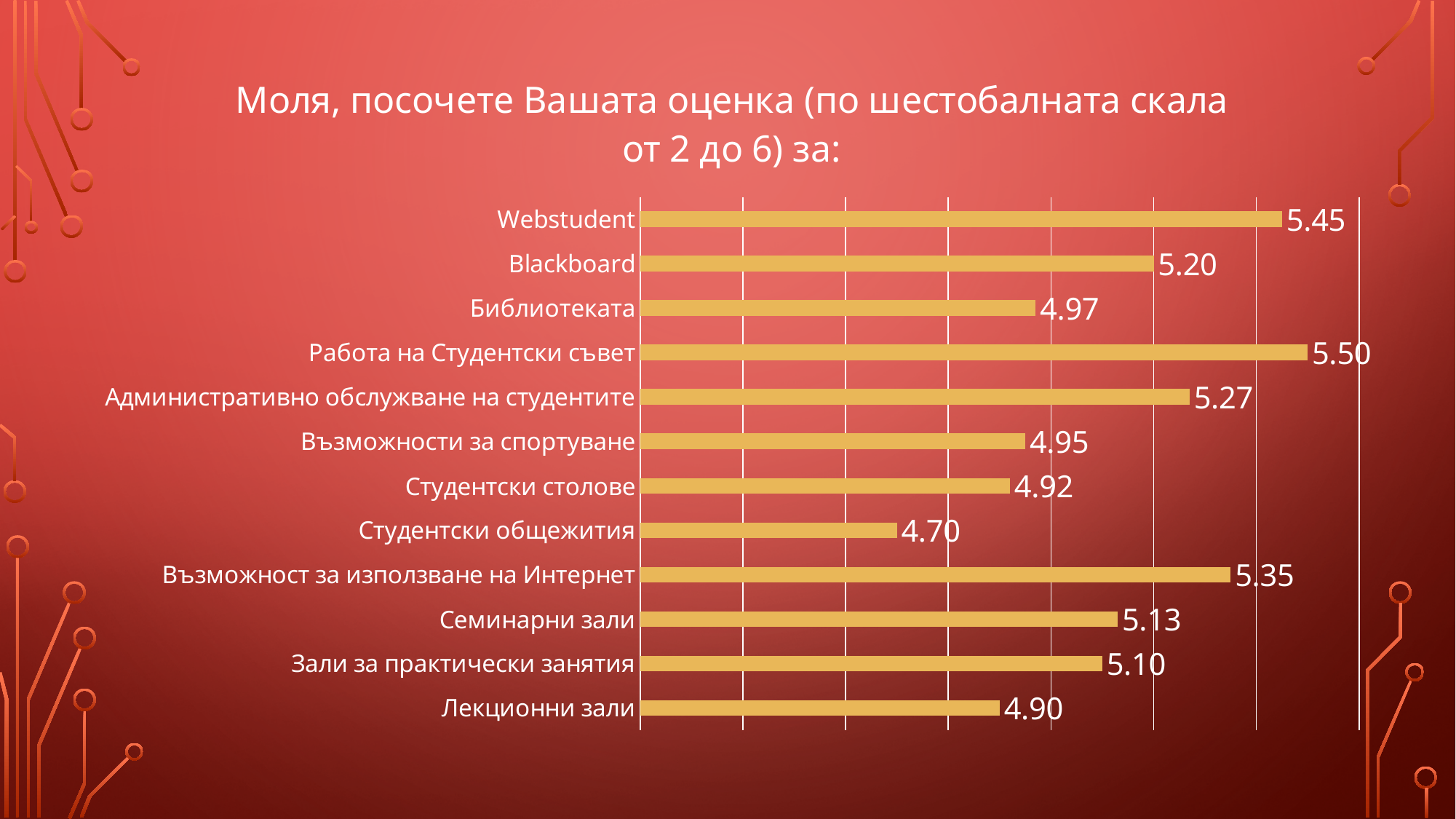
Which category has the highest value? Работа на Студентски съвет What is the difference between the values for Webstudent and Blackboard? 0.25 Which is larger, the value for Възможност за използване на Интернет or the value for Семинарни зали? Възможност за използване на Интернет What is the value for Лекционни зали? 4.90 What is the difference between the values for Работа на Студентски съвет and Студентски общежития? 0.80 What is the value for Webstudent? 5.45 What kind of chart is shown on the slide? Bar chart What is the value for Студентски общежития? 4.70 How many categories are shown in the chart? 12 What is the value for Административно обслужване на студентите? 5.27 What is the title of the slide? Моля, посочете Вашата оценка (по шестобалната скала от 2 до 6) за: Which category has the lowest value? Студентски общежития